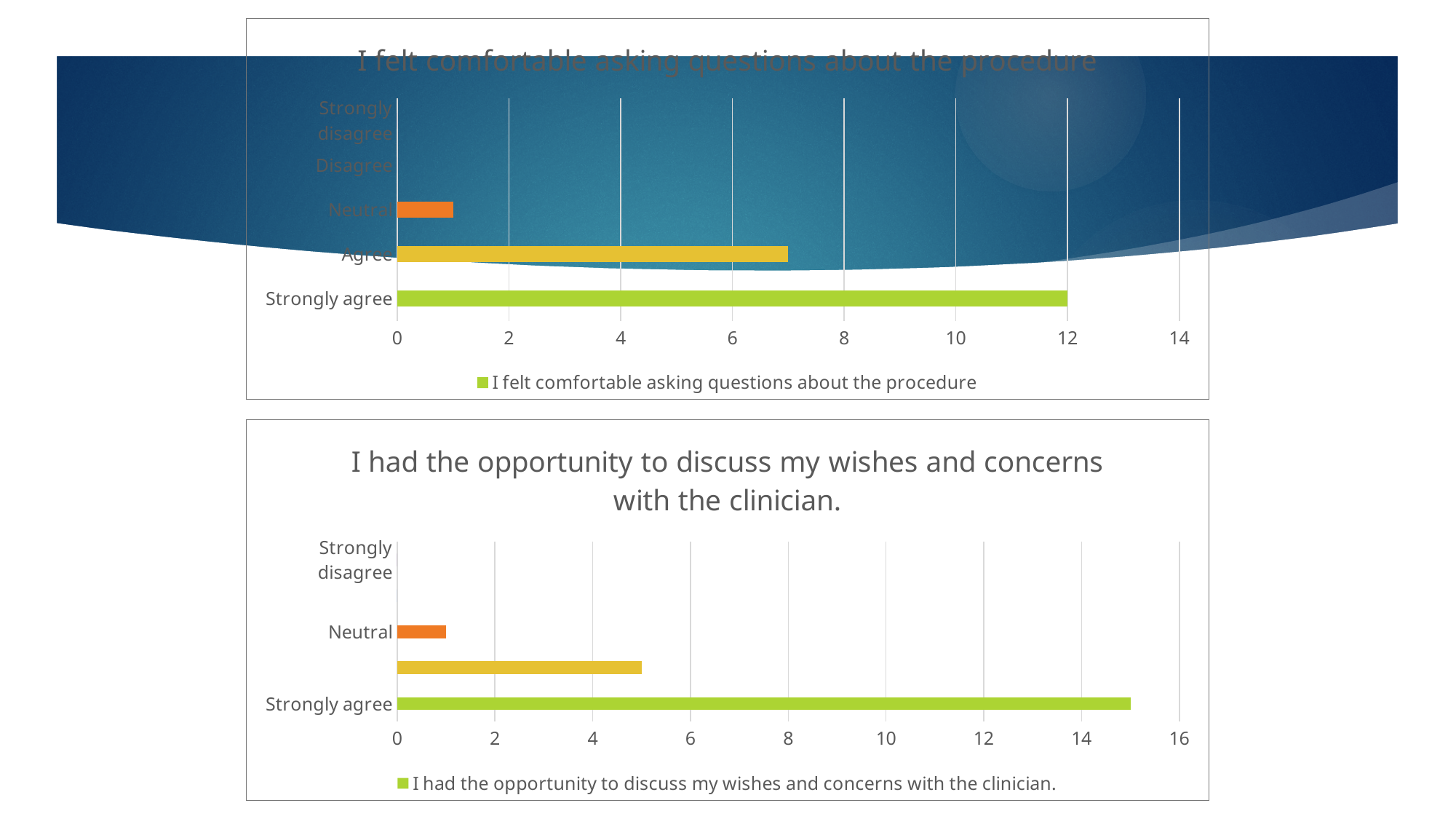
In the top chart, what is the value for Strongly agree? 12 In the top chart, which is larger, the value for Agree or the value for Neutral? Agree In the top chart, is the value for Agree greater or less than 6? greater What is the title of the bottom chart? I had the opportunity to discuss my wishes and concerns with the clinician. In the bottom chart, is the value for Strongly agree greater or less than 14? greater In the bottom chart, is the value for Neutral greater or less than 2? less In the top chart, which category has the highest value? Strongly agree What kind of chart is the top chart? bar chart How many categories are listed on the vertical axis of the top chart? 5 How many series does the legend of the bottom chart list? 1 In the bottom chart, which category has the highest value? Strongly agree